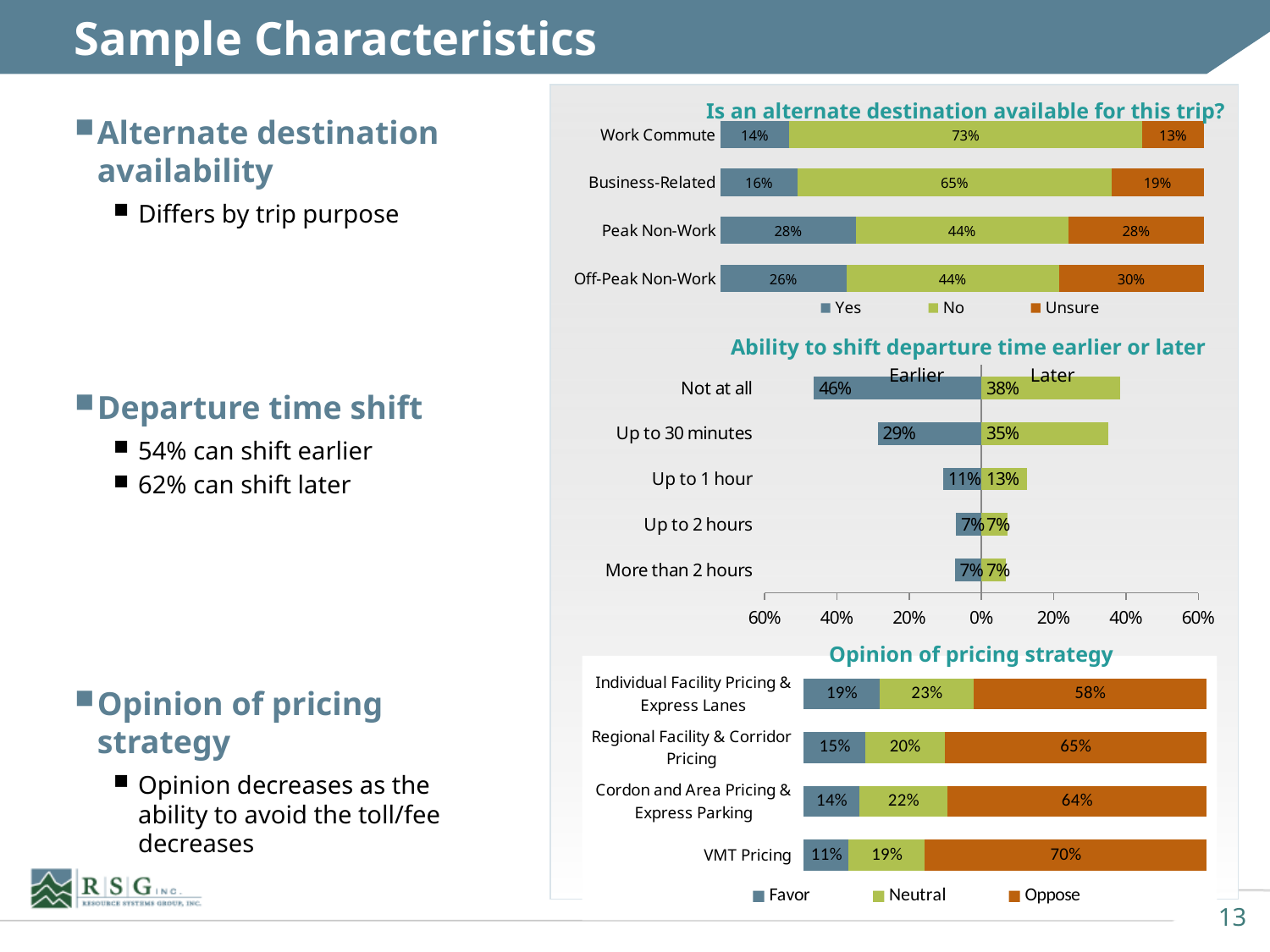
In the chart 'Ability to shift departure time earlier or later', is the Earlier value for 'Up to 1 hour' larger or smaller than the Later value for 'Up to 1 hour'? smaller In the chart 'Is an alternate destination available for this trip?', what percentage of Work Commute trips answered No? 73% In the chart 'Is an alternate destination available for this trip?', how many series does the legend list? 3 In the chart 'Is an alternate destination available for this trip?', what is the difference between the Unsure percentages for Off-Peak Non-Work and Work Commute? 17% In the chart 'Ability to shift departure time earlier or later', what percentage can shift Later by up to 30 minutes? 35% What type of chart is 'Opinion of pricing strategy'? Stacked bar chart In the chart 'Is an alternate destination available for this trip?', which trip purpose has the highest Yes percentage? Peak Non-Work In the chart 'Opinion of pricing strategy', which pricing strategy has the lowest Favor percentage? VMT Pricing In the chart 'Ability to shift departure time earlier or later', which category has the highest Earlier percentage? Not at all In the chart 'Ability to shift departure time earlier or later', how many categories are shown? 5 In the chart 'Opinion of pricing strategy', what is the difference between the Oppose percentages for Regional Facility & Corridor Pricing and Individual Facility Pricing & Express Lanes? 7% In the chart 'Opinion of pricing strategy', what percentage oppose VMT Pricing? 70%